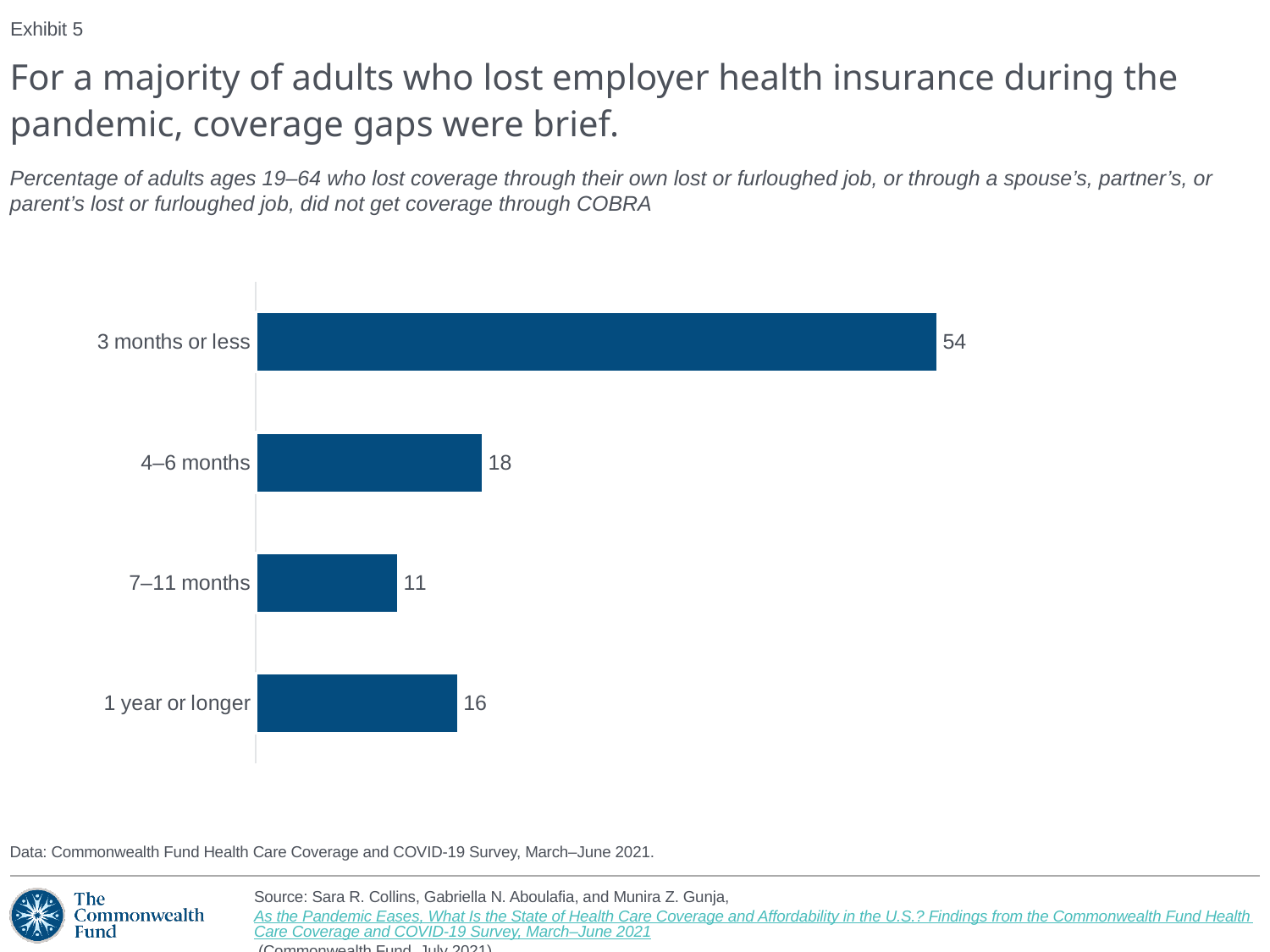
What is the difference between the values for '1 year or longer' and '7–11 months'? 5 What is the difference between the values for '3 months or less' and '4–6 months'? 36 What is the value for '4–6 months'? 18 What is the value for '7–11 months'? 11 What is the value for '1 year or longer'? 16 What is the value for '3 months or less'? 54 Which category has the highest value? 3 months or less Which category has the lowest value? 7–11 months What kind of chart is shown on the slide? Bar chart How many categories are shown in the chart? 4 What is the exhibit number shown on the slide? Exhibit 5 Which is larger, the value for '4–6 months' or the value for '1 year or longer'? 4–6 months